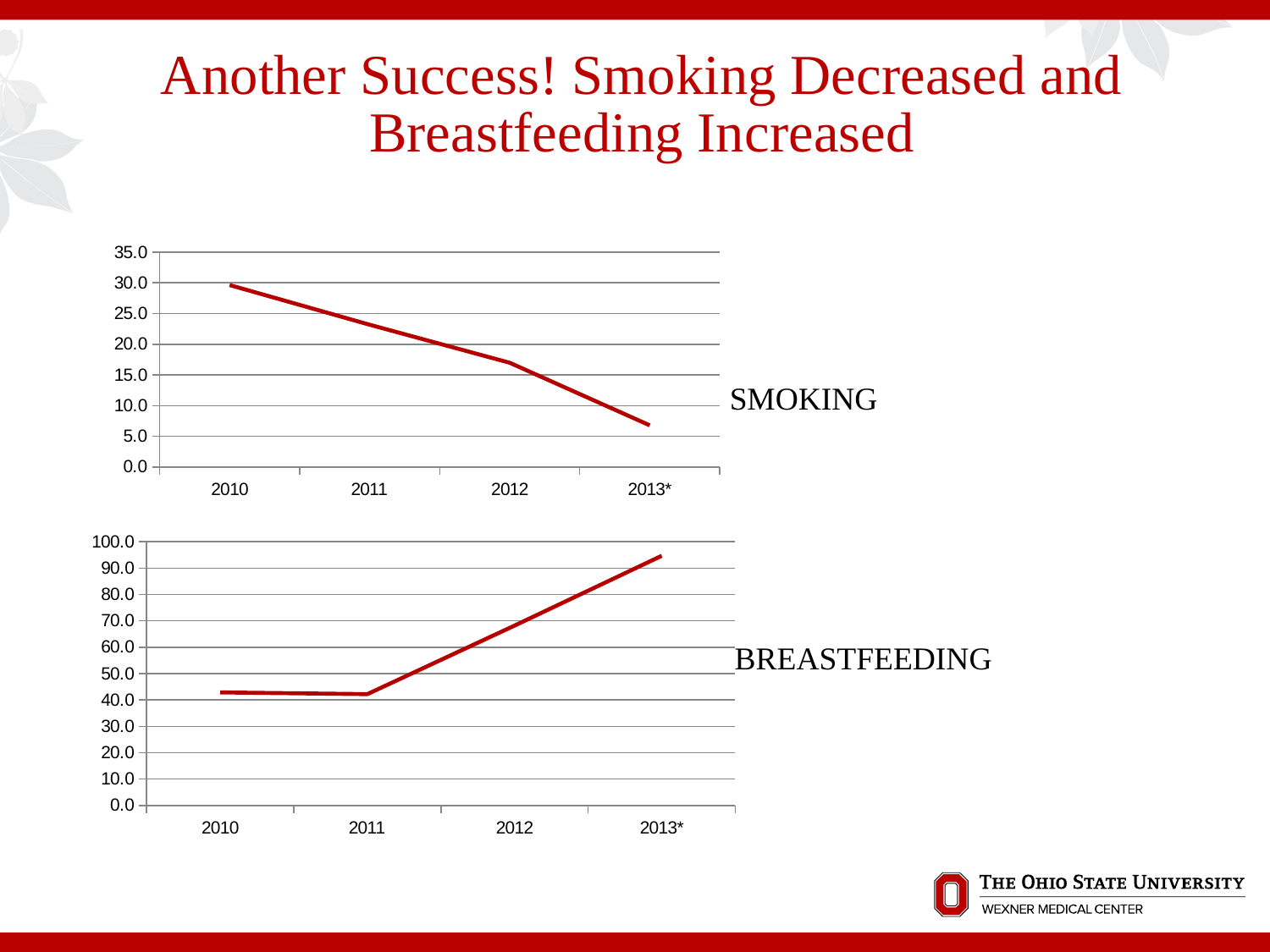
On the SMOKING chart, do the values rise or fall from 2010 to 2013*? fall On the BREASTFEEDING chart, which is larger, the value for 2010 or the value for 2012? 2012 What kind of chart is the SMOKING chart? line chart What is the label shown to the right of the top chart? SMOKING What kind of chart is the BREASTFEEDING chart? line chart On the SMOKING chart, which year has the lowest value? 2013* On the BREASTFEEDING chart, which year has the highest value? 2013* How many years are plotted on the SMOKING chart? 4 On the BREASTFEEDING chart, is the value for 2013* greater or less than 90.0? greater On the SMOKING chart, is the value for 2013* greater or less than 10.0? less On the SMOKING chart, which year has the highest value? 2010 On the BREASTFEEDING chart, do the values rise or fall from 2011 to 2013*? rise